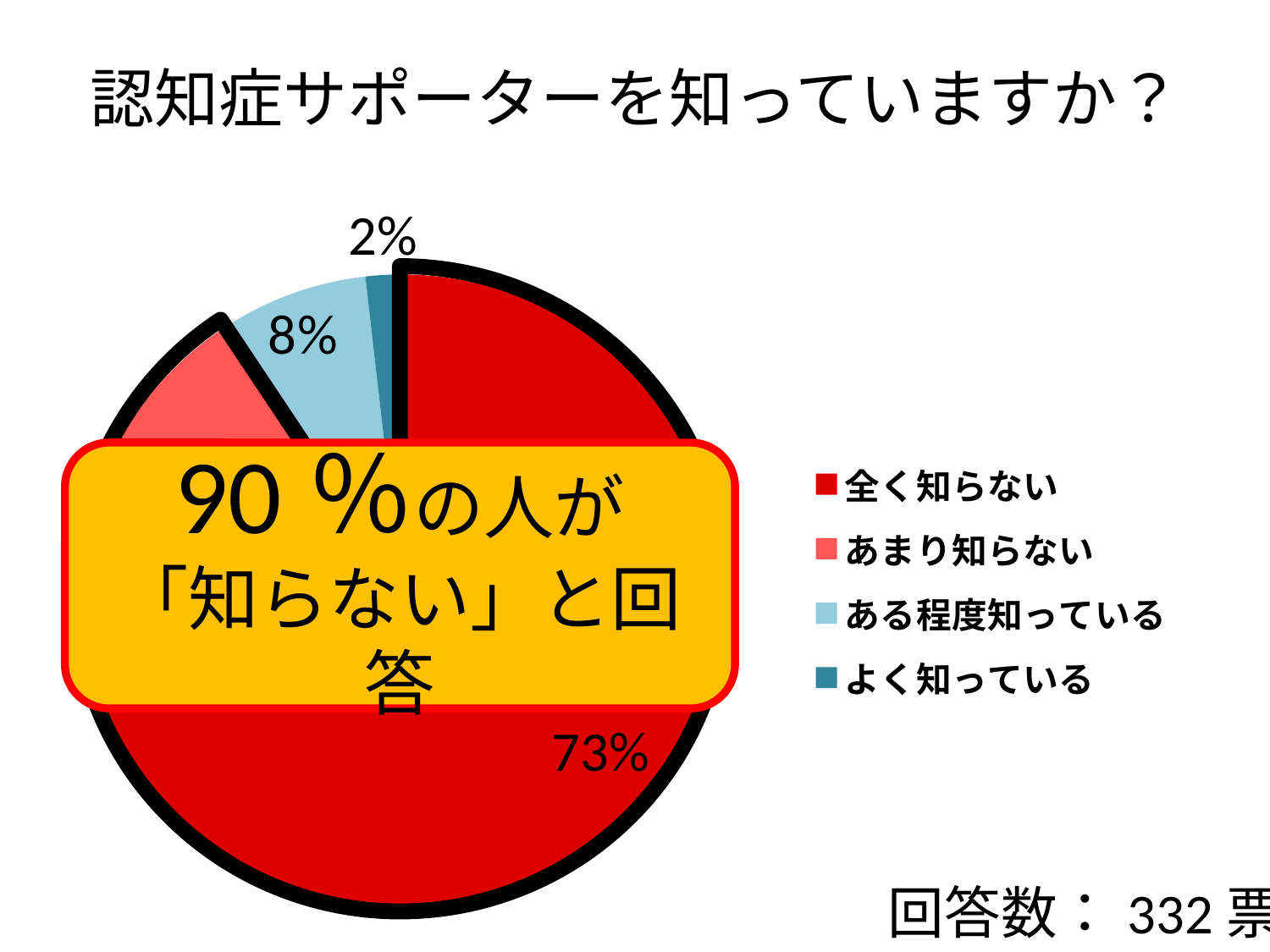
Which response category has the smallest share of the pie? よく知っている What percentage of respondents answered よく知っている? 2% What percentage of respondents answered 全く知らない? 73% Which is larger, the share for ある程度知っている or the share for よく知っている? ある程度知っている What colour represents 全く知らない in the pie chart? Red Which response category has the largest share of the pie? 全く知らない How many response categories does the legend list? 4 What is the difference in percentage points between ある程度知っている and よく知っている? 6 What kind of chart is shown on the slide? Pie chart What is the title of the chart? 認知症サポーターを知っていますか？ What percentage of respondents answered ある程度知っている? 8% What is the difference in percentage points between 全く知らない and ある程度知っている? 65